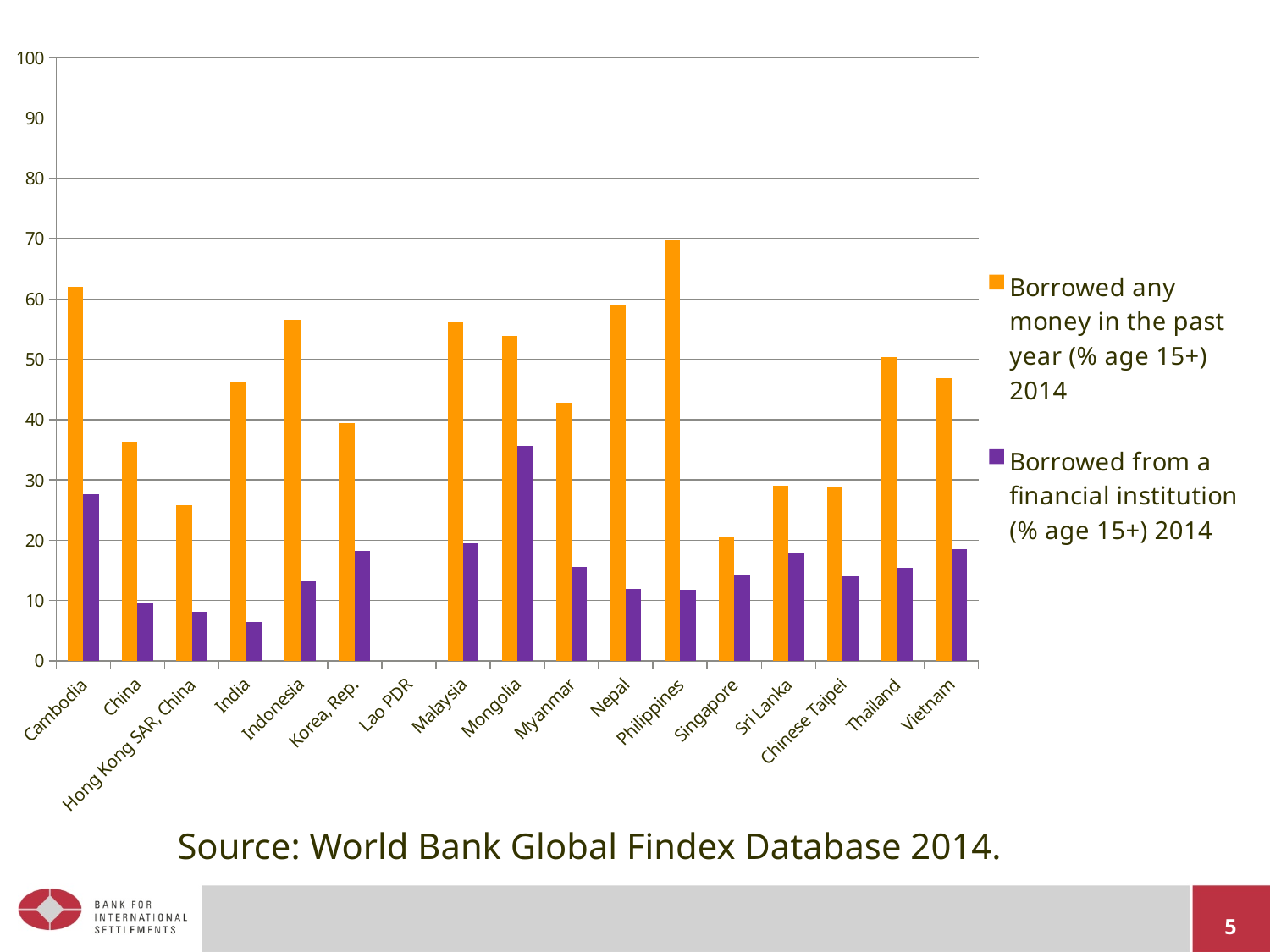
Is the value for Myanmar in the 'Borrowed any money in the past year' series greater or less than 40? greater Is the value for Mongolia in the 'Borrowed from a financial institution' series greater or less than 30? greater Is the value for Vietnam in the 'Borrowed any money in the past year' series greater or less than 50? less Which country has the highest value for 'Borrowed from a financial institution (% age 15+) 2014'? Mongolia Which is larger for 'Borrowed from a financial institution': Malaysia or Nepal? Malaysia What kind of chart is shown on the slide? bar chart Which country has the highest value for 'Borrowed any money in the past year (% age 15+) 2014'? Philippines How many series does the legend list? 2 Which is larger for 'Borrowed any money in the past year': Cambodia or Indonesia? Cambodia How many countries or economies are listed along the x axis? 17 Which country on the x axis has no bars plotted? Lao PDR